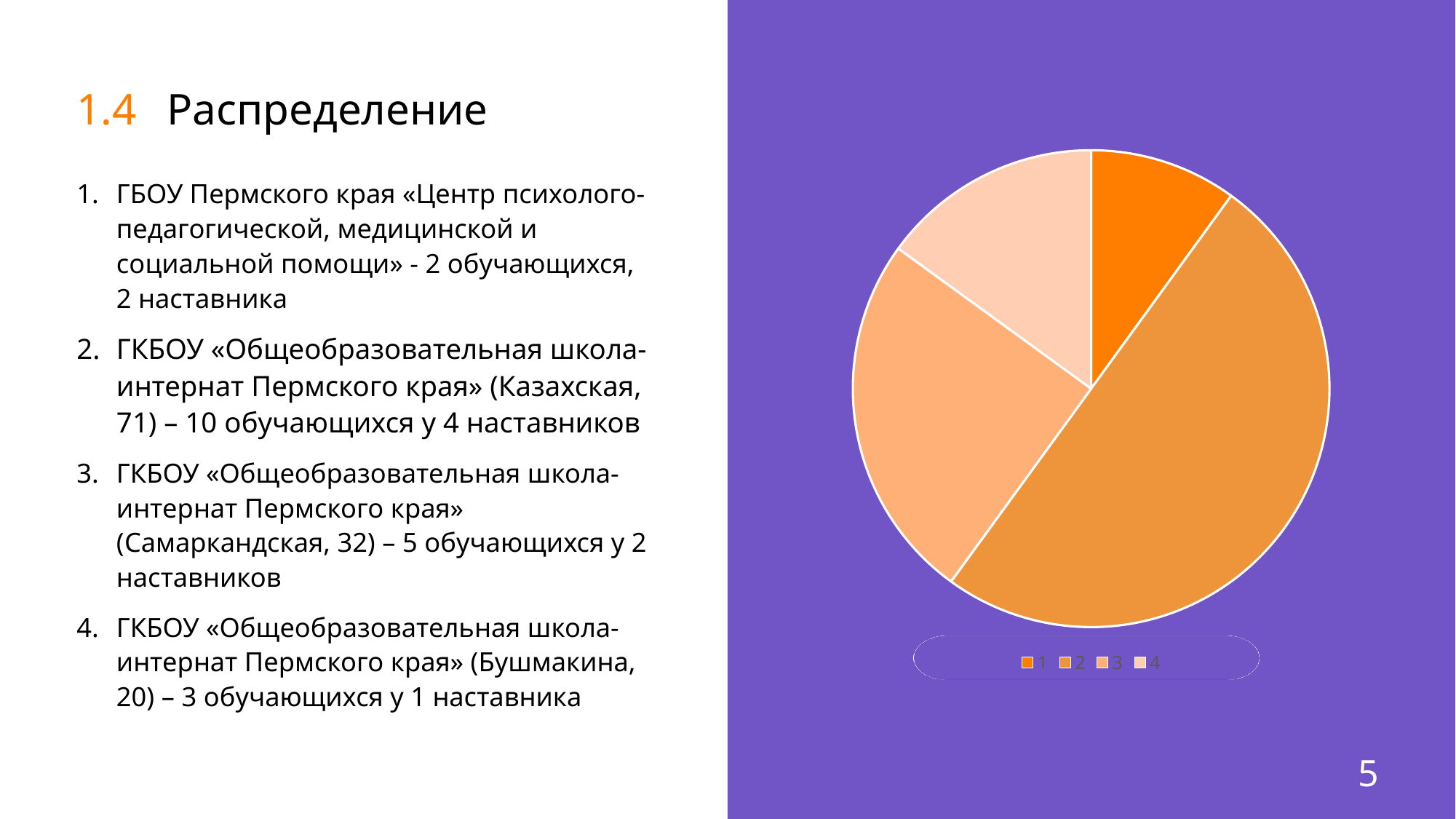
Which slice of the pie chart is the largest? 2 Which slice of the pie chart is the smallest? 1 Which slice of the pie chart is drawn in the darkest orange? 1 How many slices does the pie chart have? 4 What are the legend labels of the pie chart? 1, 2, 3, 4 What kind of chart is shown on the slide? pie chart In the pie chart, which slice is larger, 3 or 4? 3 How many entries does the legend of the pie chart list? 4 In the pie chart, which slice is larger, 1 or 3? 3 In the pie chart, which slice is larger, 1 or 4? 4